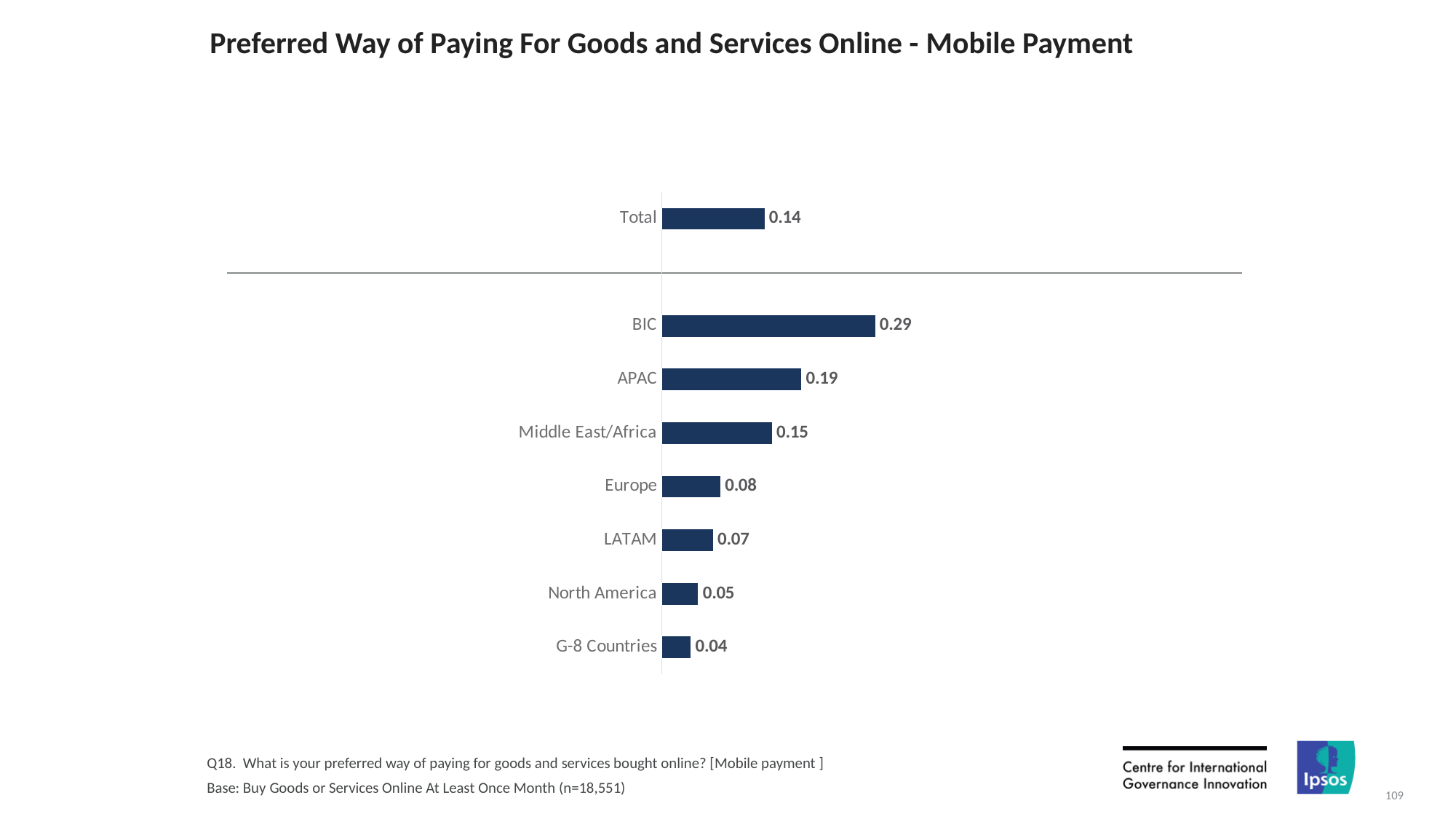
Which is larger, the value for APAC or the value for Middle East/Africa? APAC Which region has the highest value? BIC What is the value for Middle East/Africa? 0.15 What is the value for North America? 0.05 What is the value for BIC? 0.29 What is the value for Total? 0.14 Which category has the lowest value? G-8 Countries What is the difference between the values for Europe and LATAM? 0.01 What is the title of the chart? Preferred Way of Paying For Goods and Services Online - Mobile Payment How many categories are plotted on the chart? 8 What is the difference between the values for BIC and APAC? 0.10 What kind of chart is shown on the slide? Bar chart